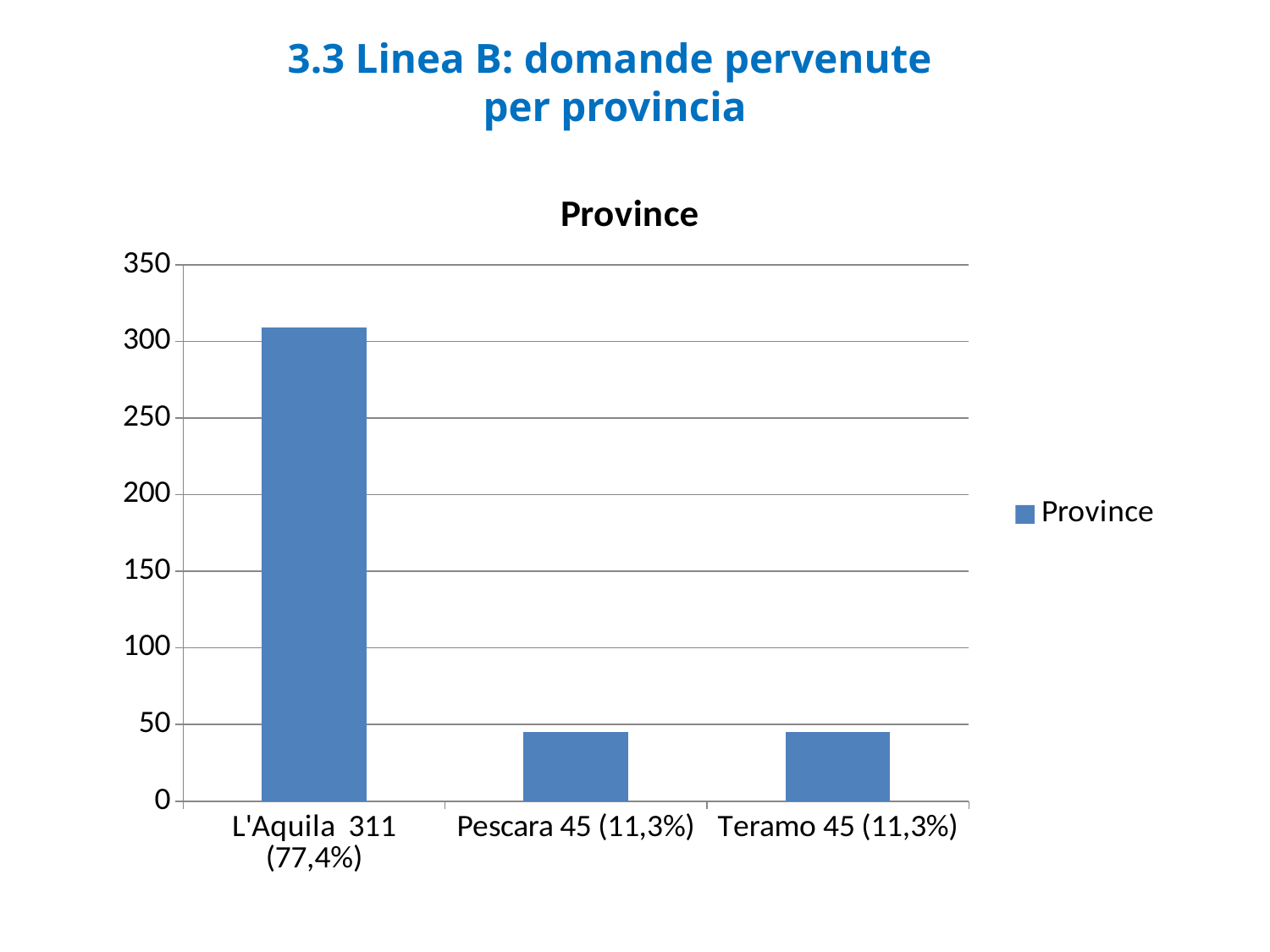
What is the difference between the values for L'Aquila and Pescara? 266 How many series does the legend list? 1 How many provinces (categories) are shown in the chart? 3 How many domande pervenute are shown for Teramo? 45 Is the value for Pescara greater or less than 50? less Which is larger, the value for L'Aquila or the value for Teramo? L'Aquila Which province has the highest value in the chart? L'Aquila What kind of chart is shown on the slide? bar chart How many domande pervenute are shown for L'Aquila? 311 What percentage share is shown for L'Aquila? 77,4% What is the title of the chart? Province How many domande pervenute are shown for Pescara? 45